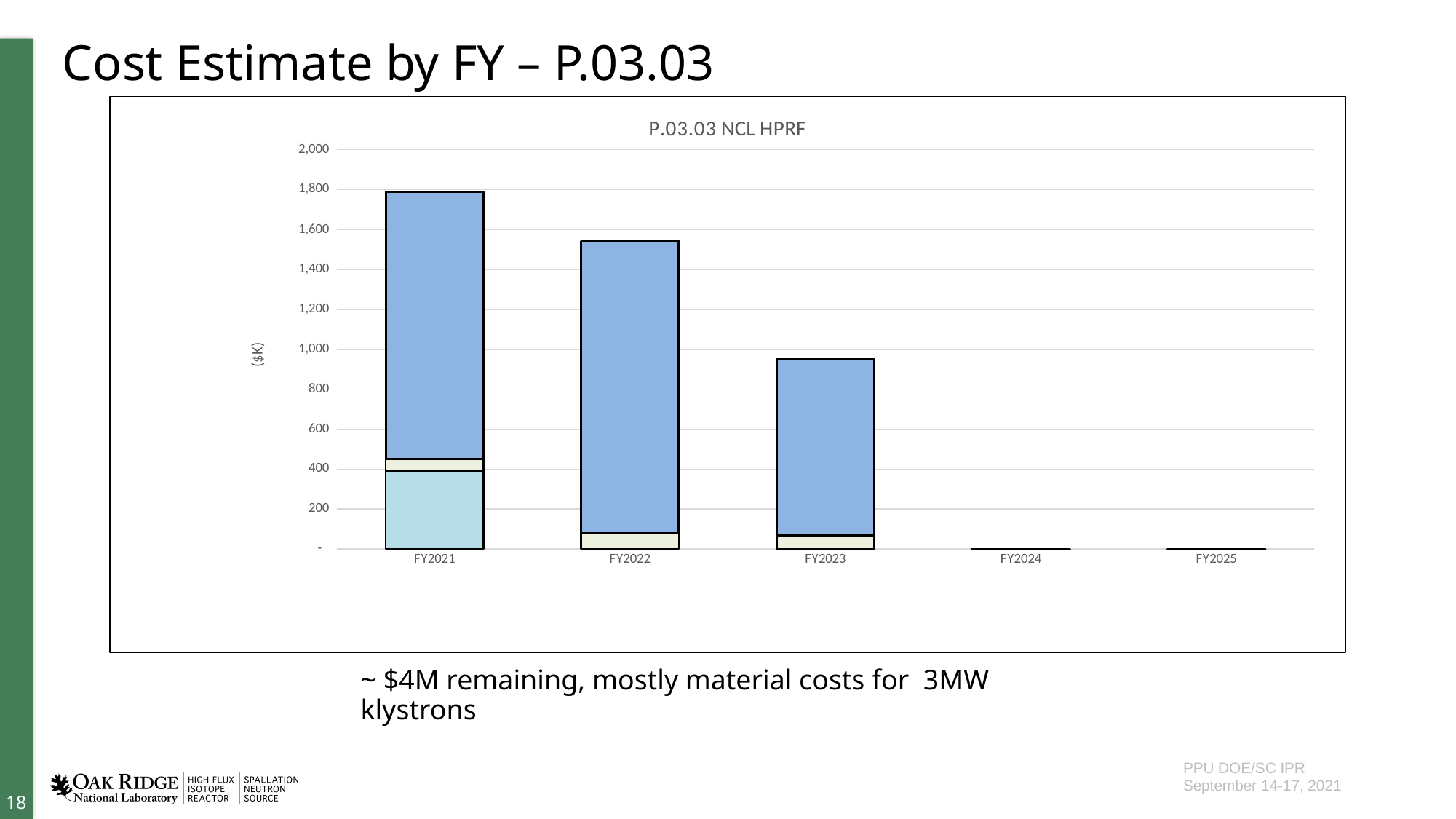
Do the bar totals rise or fall from FY2021 to FY2025? fall Is the total value for FY2023 greater or less than 1,000? less Which is larger, the total bar for FY2022 or for FY2023? FY2022 Is the total value for FY2024 greater or less than 200? less What is the title of the chart? P.03.03 NCL HPRF Is the total value for FY2021 greater or less than 1,600? greater Which is larger, the total bar for FY2021 or for FY2022? FY2021 What is the label on the vertical axis of the chart? ($K) Which fiscal year has the tallest bar? FY2021 How many fiscal year categories are shown on the x axis? 5 What kind of chart is shown on the slide? bar chart